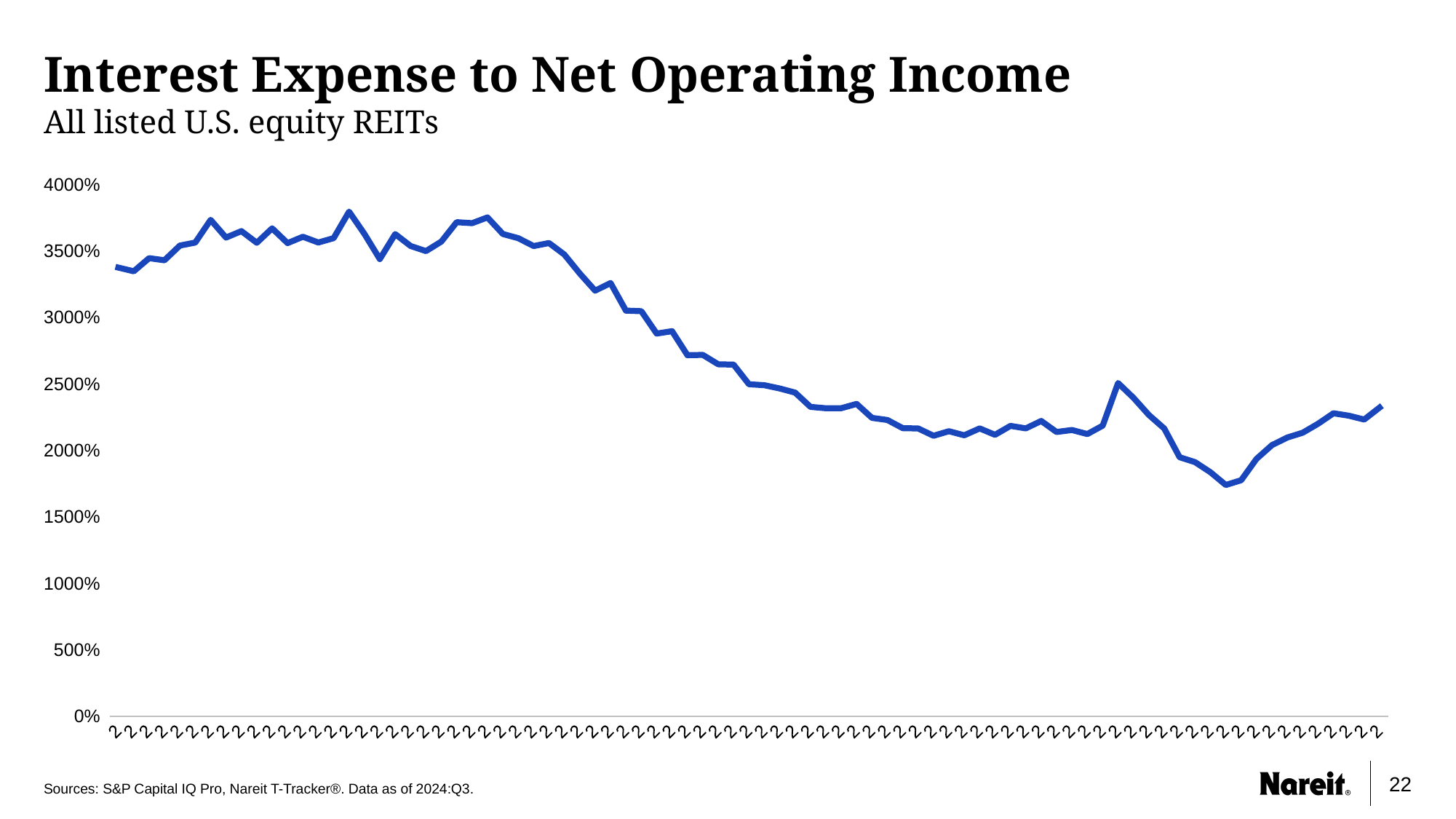
Overall, does the line rise or fall from the left of the x axis to the right? fall Does the line ever rise above 4000%? No Is the lowest point on the line greater or less than 2000%? less Which group of REITs does the chart's subtitle say the data covers? All listed U.S. equity REITs Is the lowest point on the line located in the left half or the right half of the chart? right half Is the value at the leftmost point of the line greater or less than 3000%? greater What kind of chart is shown on the slide? line chart Is the highest point on the line located in the left half or the right half of the chart? left half What is the title of the chart? Interest Expense to Net Operating Income